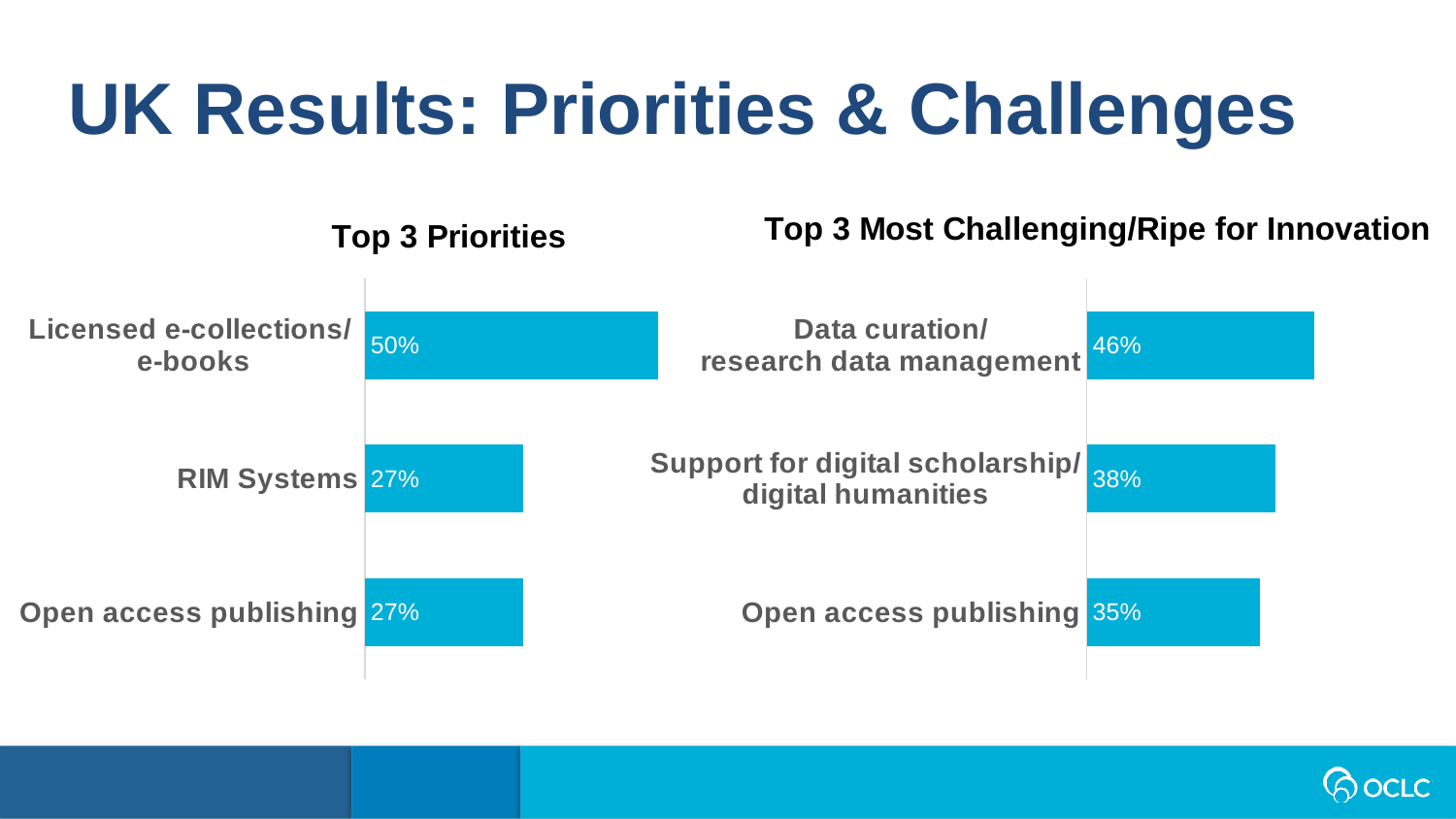
In the 'Top 3 Priorities' chart, what is the difference between Licensed e-collections/e-books and RIM Systems? 23% In the 'Top 3 Most Challenging/Ripe for Innovation' chart, what is the value for Open access publishing? 35% What is the title of the chart on the left side of the slide? Top 3 Priorities In the 'Top 3 Most Challenging/Ripe for Innovation' chart, what is the difference between Data curation/research data management and Support for digital scholarship/digital humanities? 8% In the 'Top 3 Most Challenging/Ripe for Innovation' chart, what is the value for Data curation/research data management? 46% How many categories are shown in the 'Top 3 Priorities' chart? 3 In the 'Top 3 Priorities' chart, which category has the highest value? Licensed e-collections/e-books Which is larger: Open access publishing in the 'Top 3 Priorities' chart or Open access publishing in the 'Top 3 Most Challenging/Ripe for Innovation' chart? Top 3 Most Challenging/Ripe for Innovation What kind of chart is the 'Top 3 Most Challenging/Ripe for Innovation' chart? Bar chart In the 'Top 3 Priorities' chart, what is the value for RIM Systems? 27% In the 'Top 3 Most Challenging/Ripe for Innovation' chart, which category has the lowest value? Open access publishing In the 'Top 3 Priorities' chart, what is the value for Licensed e-collections/e-books? 50%